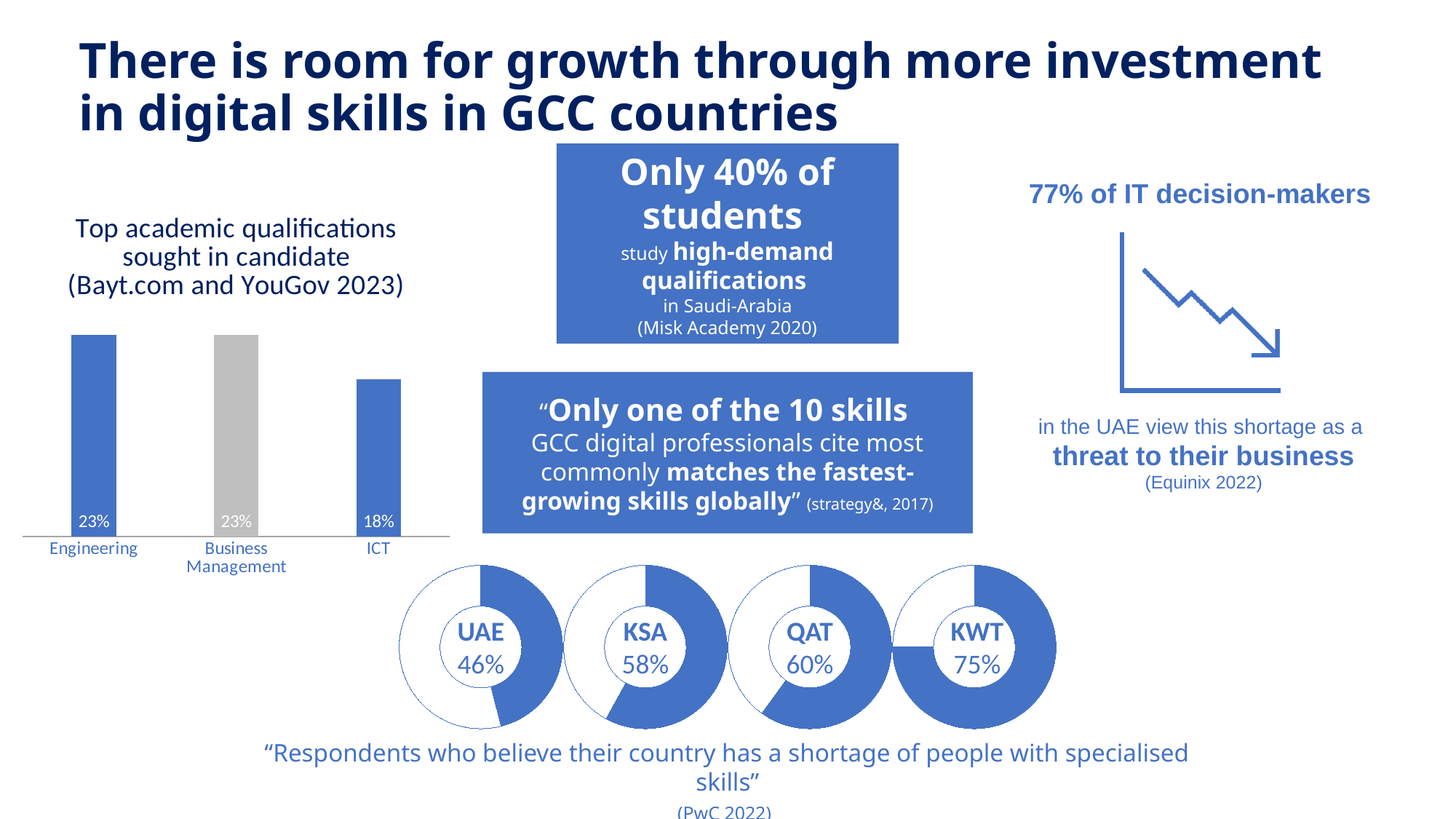
In the donut charts at the bottom of the slide, what is the difference between the KWT and KSA values? 17% In the donut charts at the bottom of the slide, which country has the highest value? KWT In the 'Top academic qualifications sought in candidate' bar chart, what is the value for Engineering? 23% In the 'Top academic qualifications sought in candidate' bar chart, which category has the lowest value? ICT In the 'Top academic qualifications sought in candidate' bar chart, what is the value for ICT? 18% In the donut charts at the bottom of the slide, what is the value for UAE? 46% In the donut charts at the bottom of the slide, what is the value for KSA? 58% What kind of chart is the 'Top academic qualifications sought in candidate' chart? Bar chart In the 'Top academic qualifications sought in candidate' bar chart, how many categories are shown? 3 In the 'Top academic qualifications sought in candidate' bar chart, which bar is coloured grey? Business Management In the donut charts at the bottom of the slide, which is larger, the value for QAT or the value for UAE? QAT In the 'Top academic qualifications sought in candidate' bar chart, what is the difference between the Engineering and ICT values? 5%